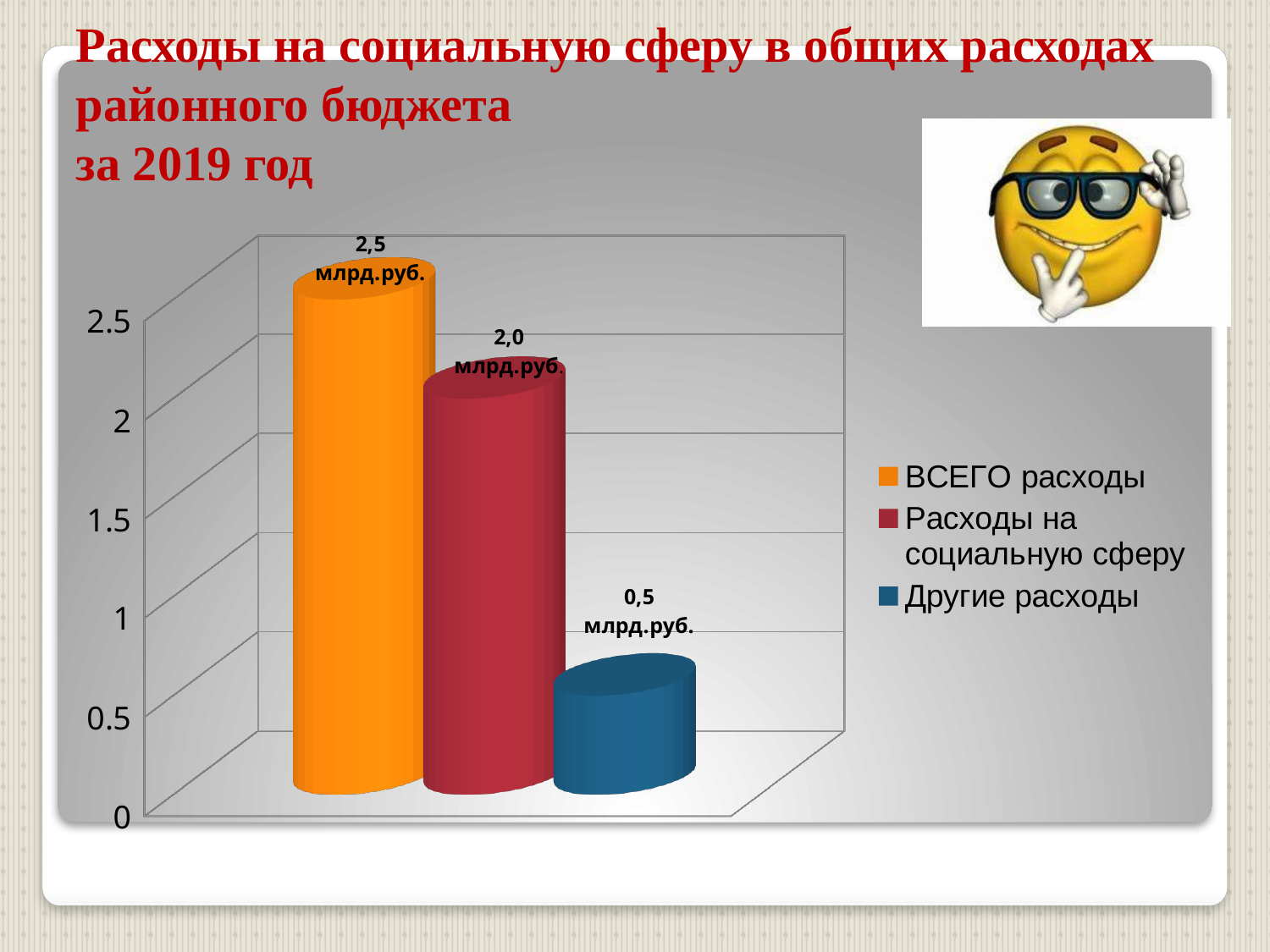
What kind of chart is shown on the slide? Bar chart What is the difference between ВСЕГО расходы and Расходы на социальную сферу? 0,5 млрд.руб. What value is shown for ВСЕГО расходы? 2,5 млрд.руб. Which is larger: Расходы на социальную сферу or Другие расходы? Расходы на социальную сферу How many series does the legend list? 3 What colour is the bar for Другие расходы? Blue What value is shown for Расходы на социальную сферу? 2,0 млрд.руб. What value is shown for Другие расходы? 0,5 млрд.руб. Is the value for Другие расходы greater or less than 1? less Which series has the lowest value? Другие расходы Which series has the highest value? ВСЕГО расходы What is the difference between Расходы на социальную сферу and Другие расходы? 1,5 млрд.руб.